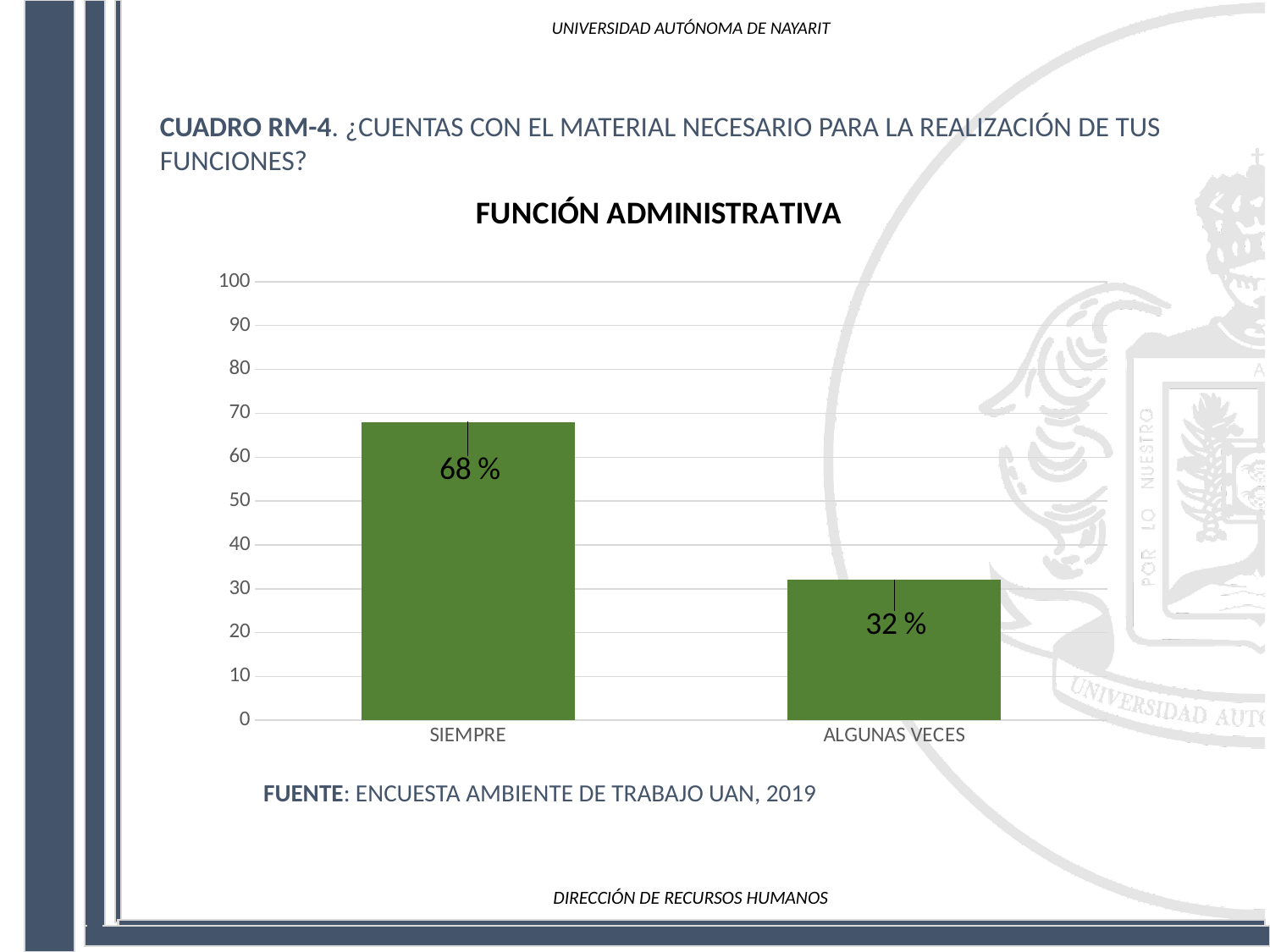
Is the value for SIEMPRE greater or less than 60? greater What is the title of the chart? FUNCIÓN ADMINISTRATIVA How many categories are shown on the x axis? 2 Which category has the highest value? SIEMPRE What is the difference between the values for SIEMPRE and ALGUNAS VECES? 36 % Is the value for ALGUNAS VECES greater or less than 40? less What kind of chart is shown on the slide? bar chart Which category has the lowest value? ALGUNAS VECES What is the highest value shown on the vertical axis? 100 What is the value for SIEMPRE? 68 % Which is larger, the value for SIEMPRE or the value for ALGUNAS VECES? SIEMPRE What is the value for ALGUNAS VECES? 32 %